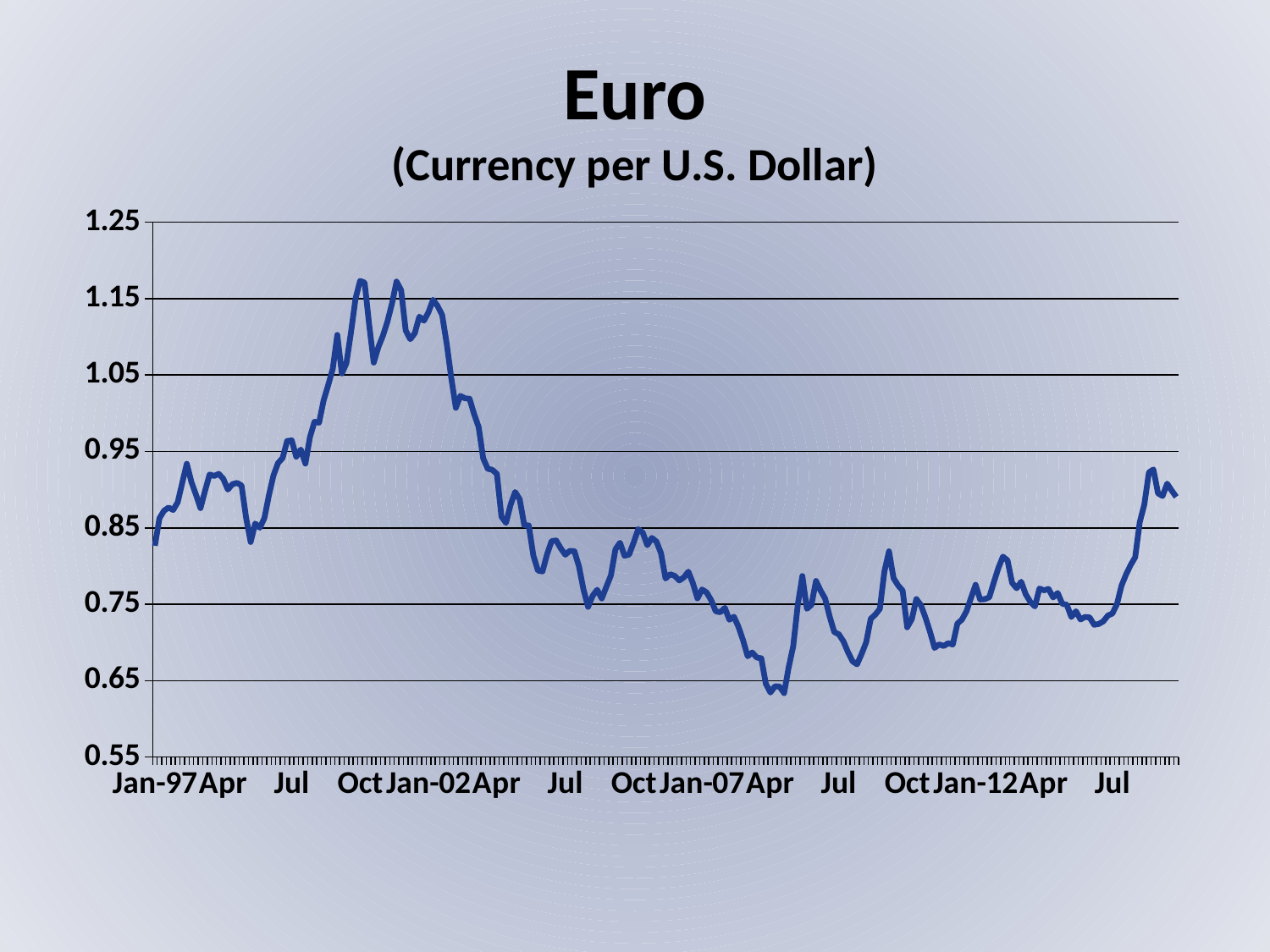
Is the lowest point on the line greater or less than 0.75? less Is the value around Jan-02 greater or less than 1.05? greater What is the title of the chart? Euro What is the highest value shown on the y axis? 1.25 What unit does the chart subtitle say the values are in? Currency per U.S. Dollar Which is larger, the value around Jan-02 or the value around Jan-07? Jan-02 Is the value around Jan-12 greater or less than 0.85? less Does the line generally rise or fall between Jan-97 and Jan-02? rise What kind of chart is shown on the slide? line chart Does the line generally rise or fall between Jan-02 and Jan-07? fall